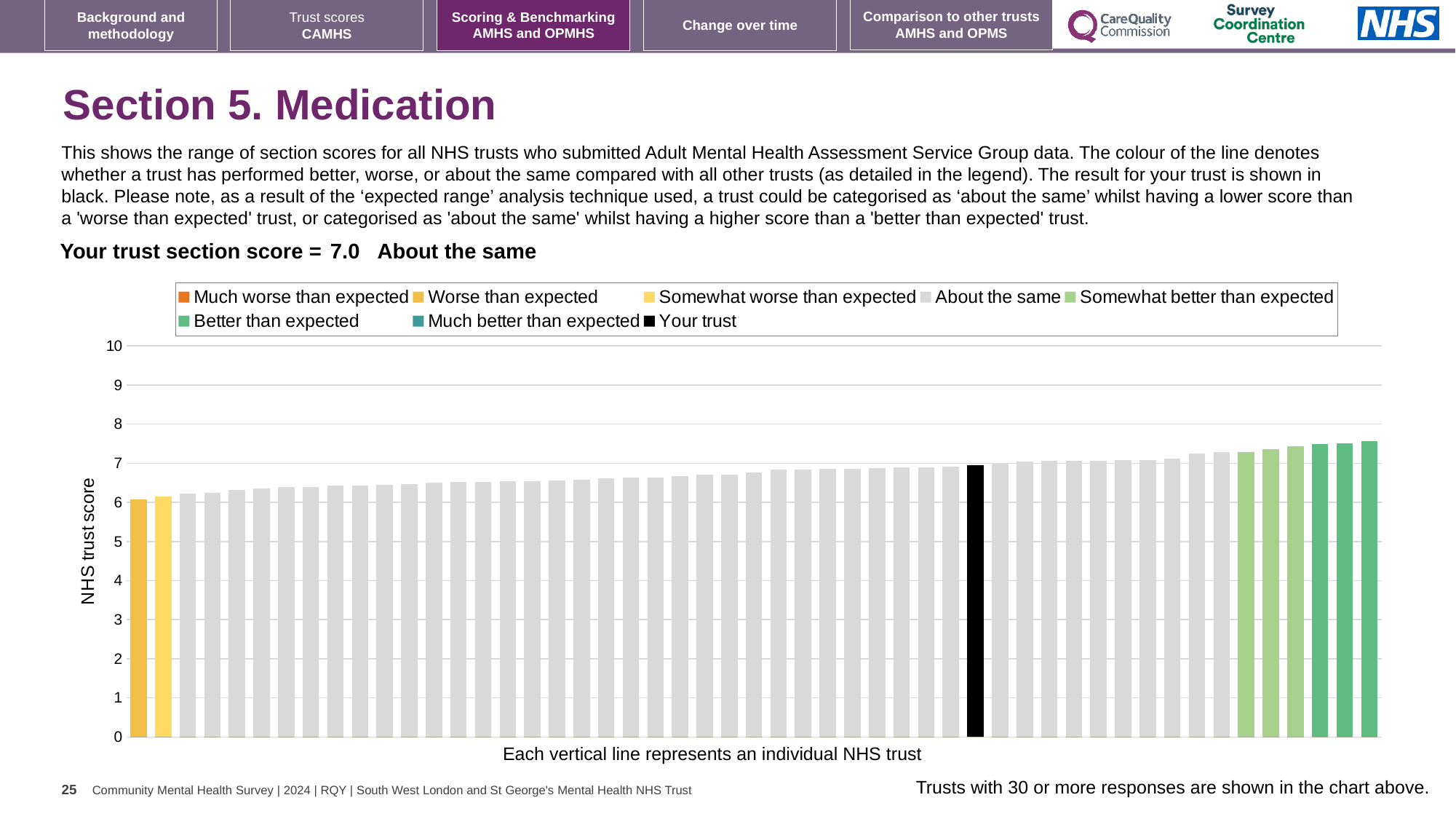
What is the label on the vertical axis of the chart? NHS trust score Is the value of the highest bar greater or less than 8? less Is the rightmost bar higher or lower than the leftmost bar? higher How many entries does the chart legend list? 8 What kind of chart is shown on the slide? bar chart How many bars are coloured as 'Worse than expected' (the darker yellow)? 1 Do the bar values rise or fall from left to right along the x axis? rise What colour is the bar representing your trust? black Is the value for your trust greater or less than 5? greater Which category is your trust placed in for this section? About the same Is the value of the lowest bar greater or less than 5? greater What is the section score for your trust shown on the slide? 7.0